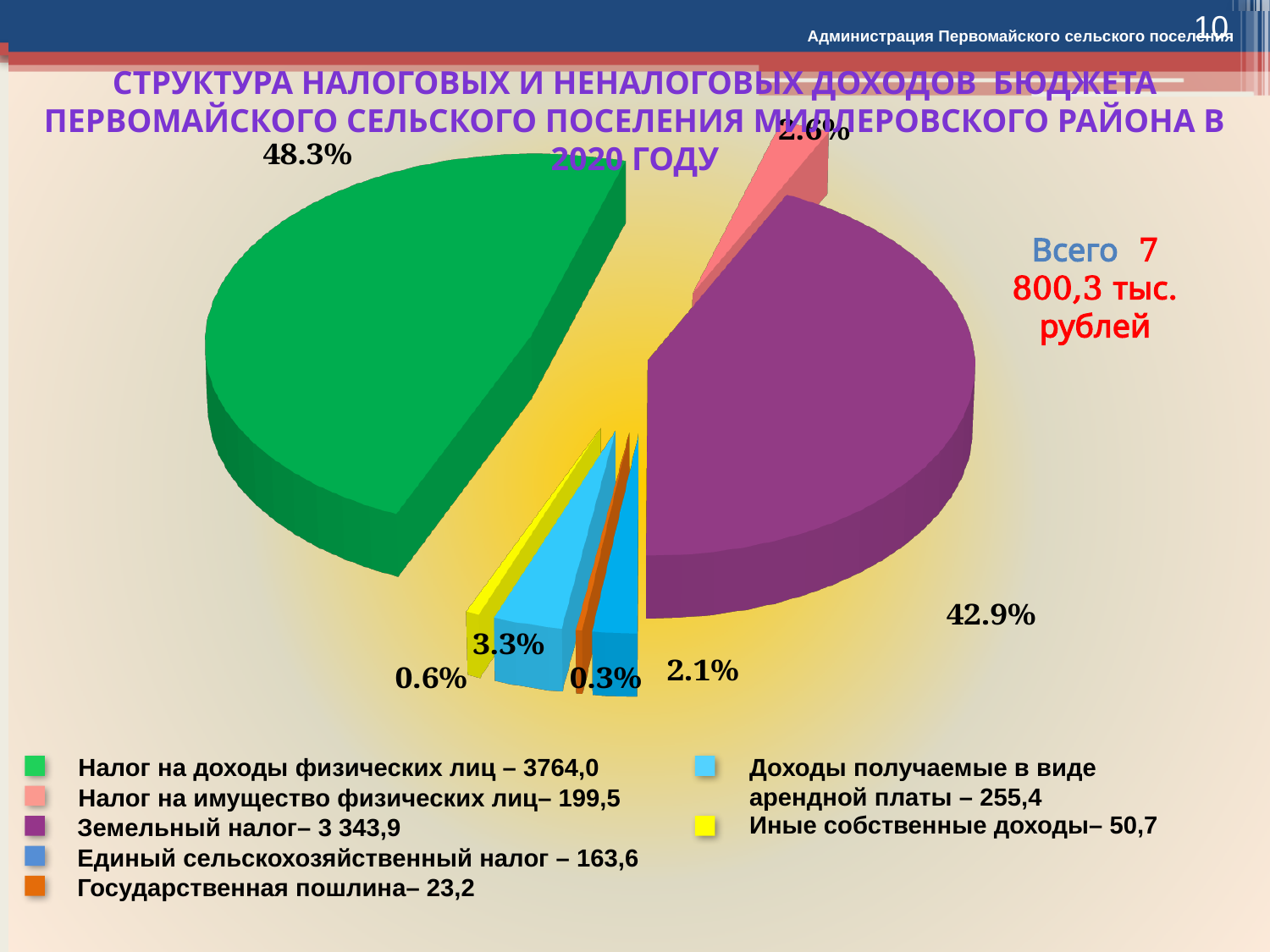
What is the difference in percentage points between the green slice (48.3%) and the purple slice (42.9%)? 5.4 What colour is used for "Иные собственные доходы" in the legend? yellow What percentage is shown for the pink slice, "Налог на имущество физических лиц"? 2.6% What type of chart is shown on the slide? pie chart What value does the legend give for "Земельный налог"? 3 343,9 Which is larger: the share for "Доходы получаемые в виде арендной платы" or the share for "Единый сельскохозяйственный налог"? Доходы получаемые в виде арендной платы What share of the pie does "Налог на доходы физических лиц" (green slice) represent? 48.3% Which category has the smallest slice of the pie? Государственная пошлина What total amount is stated on the slide for all revenues? 7 800,3 тыс. рублей What share of the pie does "Земельный налог" (purple slice) represent? 42.9% Which category has the largest slice of the pie? Налог на доходы физических лиц How many slices does the pie chart have? 7